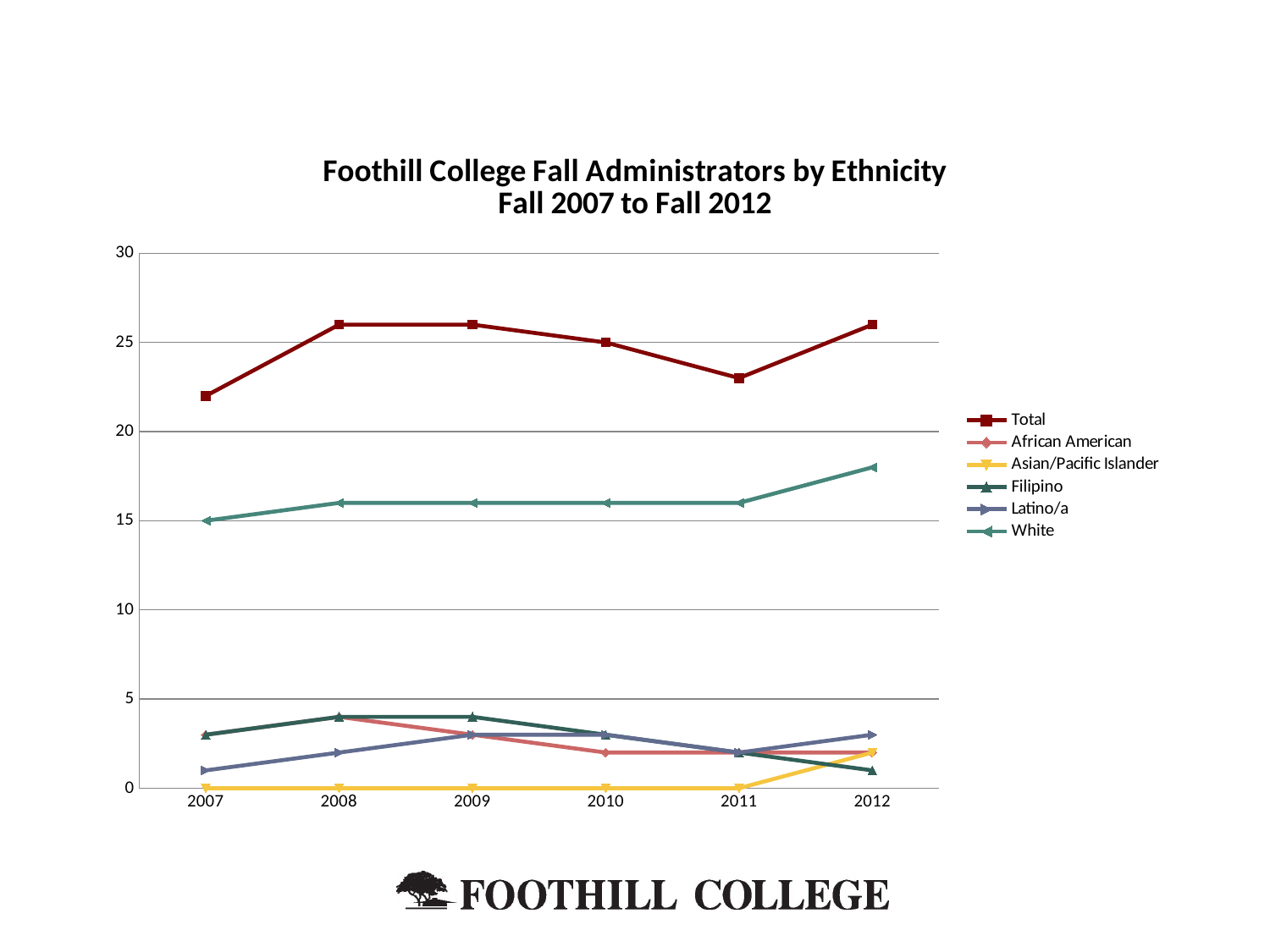
How many years are plotted along the x axis? 6 Is the value for White in 2012 greater or less than 20? less What is the value for Total in 2010? 25 What type of chart is shown on the slide? line chart How many series does the legend list? 6 In which year is the Total series lowest? 2007 Which series has the highest value in 2012, excluding Total? White What is the value for Asian/Pacific Islander in 2009? 0 What is the value for White in 2007? 15 Which is larger in 2011: the value for Total or the value for White? Total Does the White series rise or fall from 2011 to 2012? rise Is the value for Total in 2008 greater or less than 25? greater